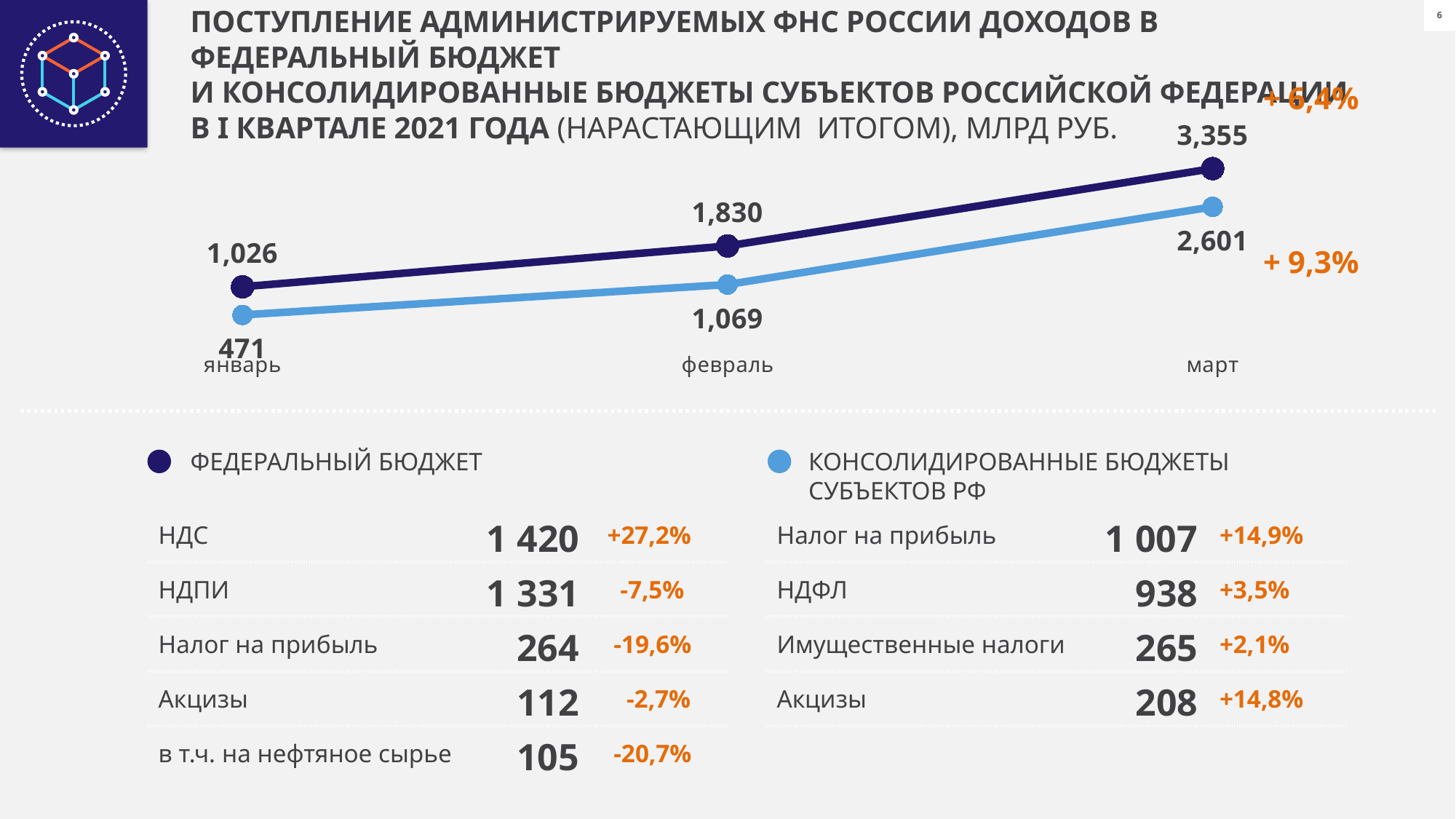
What is the value for КОНСОЛИДИРОВАННЫЕ БЮДЖЕТЫ СУБЪЕКТОВ РФ in январь? 471 Which series has the larger value in февраль, ФЕДЕРАЛЬНЫЙ БЮДЖЕТ or КОНСОЛИДИРОВАННЫЕ БЮДЖЕТЫ СУБЪЕКТОВ РФ? ФЕДЕРАЛЬНЫЙ БЮДЖЕТ In which month is the value for ФЕДЕРАЛЬНЫЙ БЮДЖЕТ highest? март What type of chart is shown on the slide? line chart In which month is the value for КОНСОЛИДИРОВАННЫЕ БЮДЖЕТЫ СУБЪЕКТОВ РФ lowest? январь Do the values for ФЕДЕРАЛЬНЫЙ БЮДЖЕТ rise or fall from январь to март? rise What is the value for ФЕДЕРАЛЬНЫЙ БЮДЖЕТ in февраль? 1,830 What is the value for ФЕДЕРАЛЬНЫЙ БЮДЖЕТ in март? 3,355 What is the value for КОНСОЛИДИРОВАННЫЕ БЮДЖЕТЫ СУБЪЕКТОВ РФ in март? 2,601 How many series does the legend list? 2 What is the difference between ФЕДЕРАЛЬНЫЙ БЮДЖЕТ and КОНСОЛИДИРОВАННЫЕ БЮДЖЕТЫ СУБЪЕКТОВ РФ in март? 754 How many points (months) are plotted along the x axis? 3